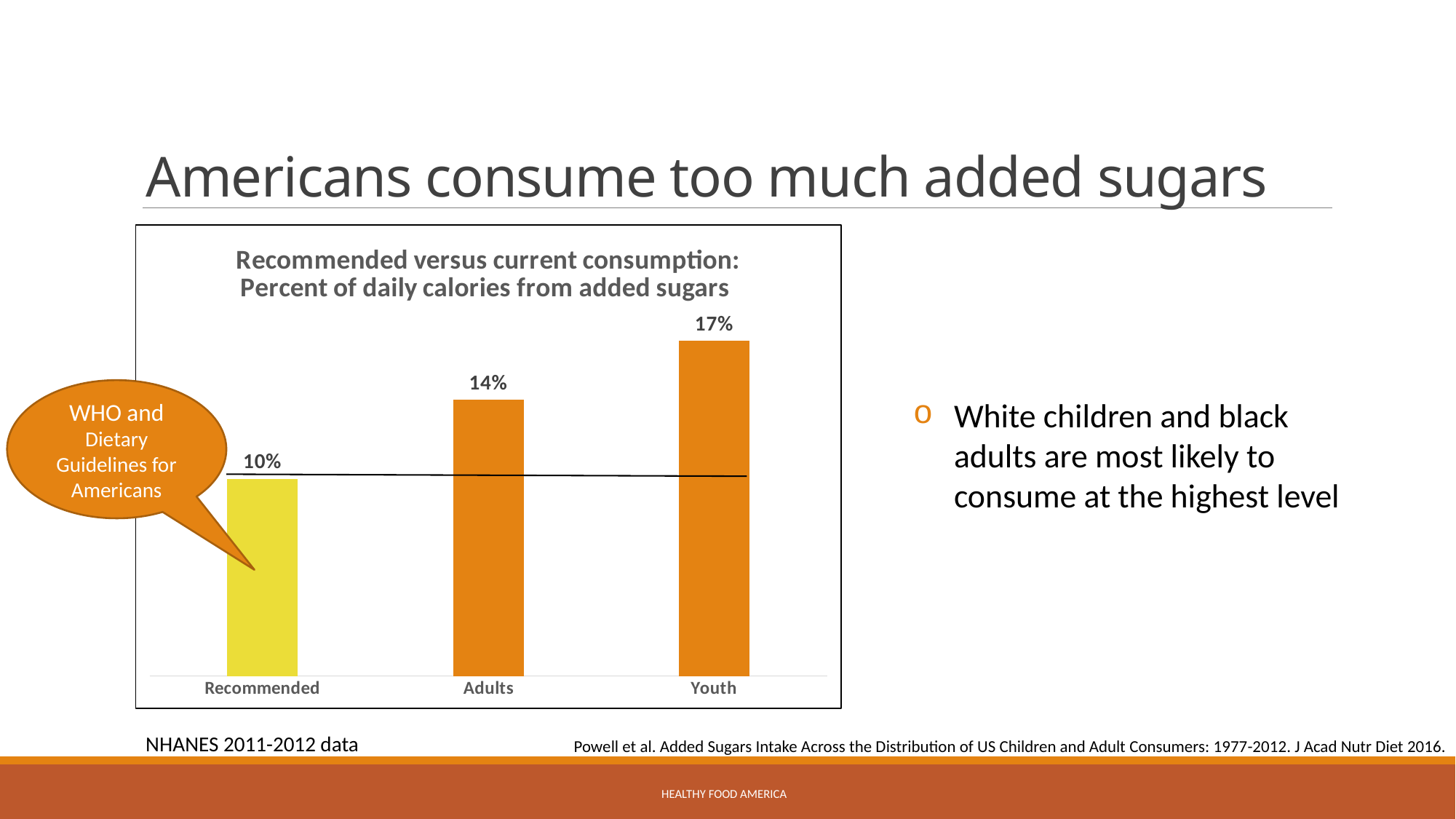
Which is larger, the value for Adults or the value for Youth? Youth What is the difference between the Youth value and the Recommended value? 7% How many categories are shown on the x axis? 3 Do the values rise or fall from left to right along the x axis? Rise What is the title of the chart? Recommended versus current consumption: Percent of daily calories from added sugars What is the value for Youth? 17% What is the difference between the Adults value and the Recommended value? 4% What is the value for Recommended? 10% What is the value for Adults? 14% Which category has the highest value? Youth What kind of chart is shown on the slide? Bar chart Which category has the lowest value? Recommended